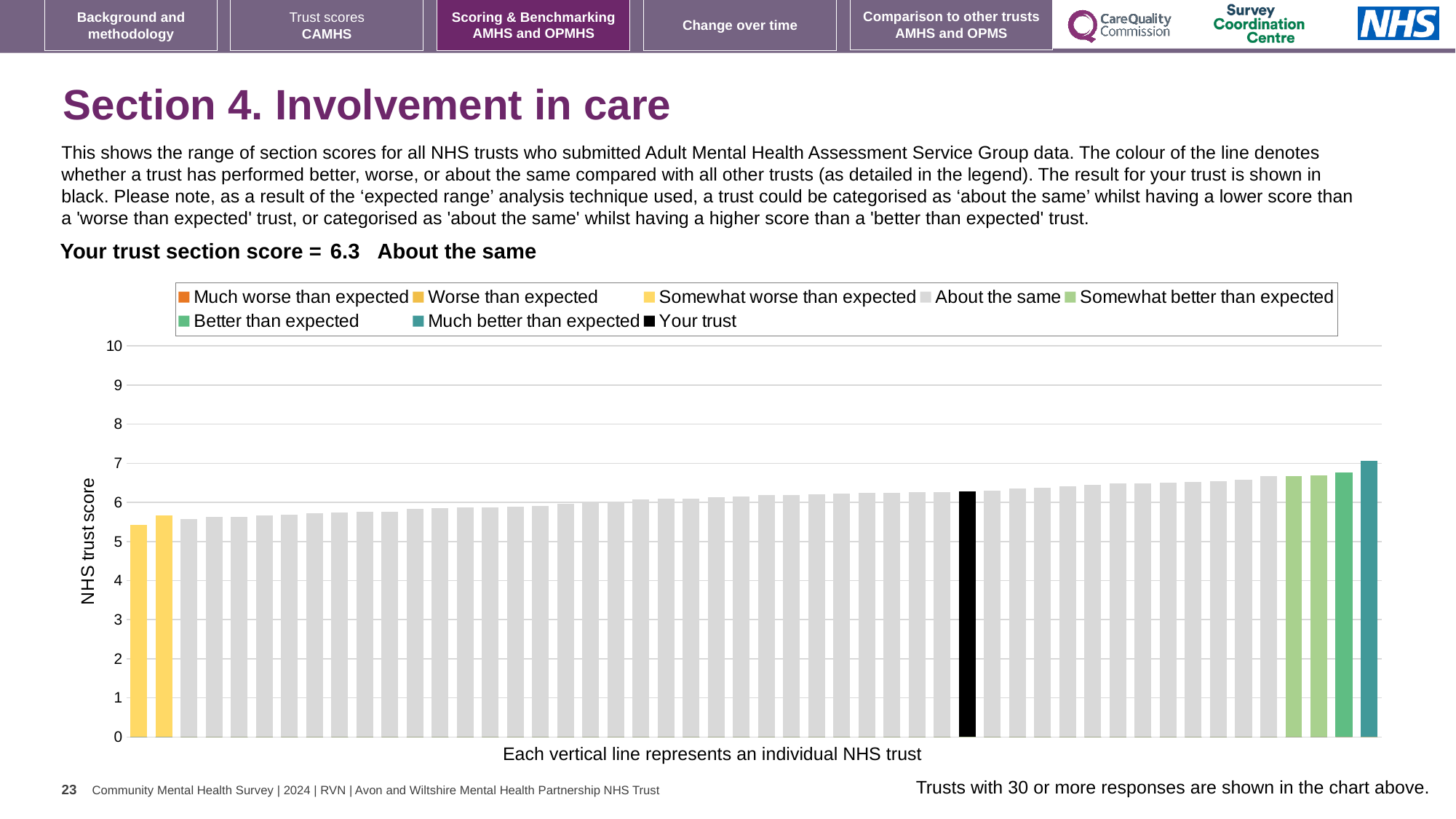
Do the bar values rise or fall from left to right across the chart? rise Is the value of the rightmost (highest) bar greater or less than 6? greater Which legend category does the highest bar in the chart belong to? Much better than expected Is the value of the leftmost (lowest) bar greater or less than 5? greater Is the value of the leftmost (lowest) bar greater or less than 6? less Which is higher: the black 'Your trust' bar or the rightmost teal bar? the rightmost teal bar How many entries does the chart legend list? 8 What is the label on the vertical axis of the chart? NHS trust score What kind of chart is shown on the slide? bar chart What is the section score for your trust (the black bar)? 6.3